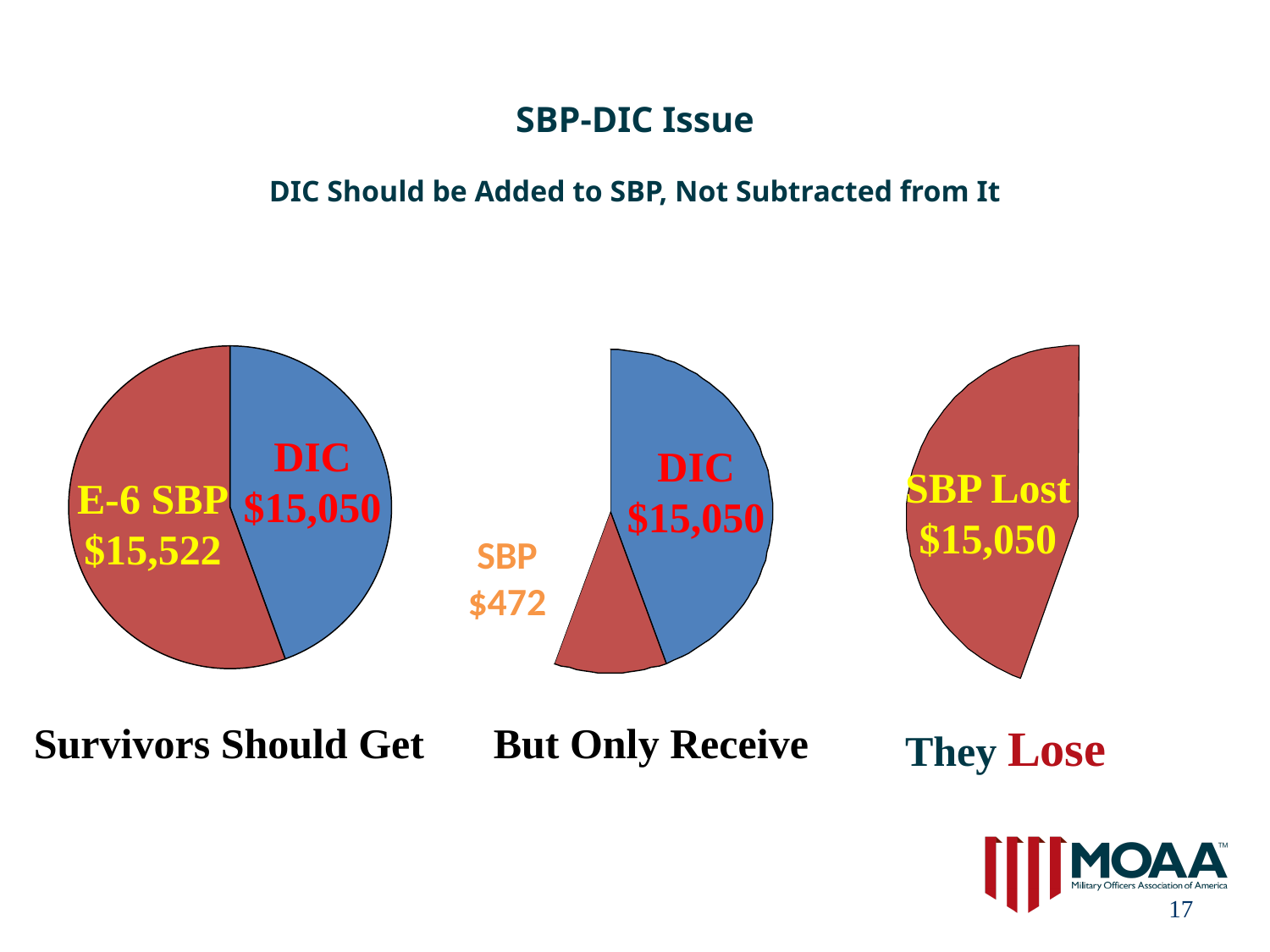
In the 'They Lose' chart on the right, what is the value for SBP Lost? $15,050 In the 'Survivors Should Get' chart on the left, what is the value for E-6 SBP? $15,522 In the 'Survivors Should Get' chart on the left, which is larger, E-6 SBP or DIC? E-6 SBP In the 'Survivors Should Get' chart on the left, what is the value for DIC? $15,050 In the 'But Only Receive' chart in the middle, which slice is the largest? DIC What kind of chart is used in the 'Survivors Should Get' chart on the left? pie chart In the 'But Only Receive' chart in the middle, which slice is the smallest? SBP In the 'But Only Receive' chart in the middle, what is the difference between DIC and SBP? $14,578 In the 'Survivors Should Get' chart on the left, what is the difference between E-6 SBP and DIC? $472 In the 'But Only Receive' chart in the middle, what is the value for SBP? $472 In the 'Survivors Should Get' chart on the left, what colour is the DIC slice? blue How many slices does the 'Survivors Should Get' chart on the left have? 2